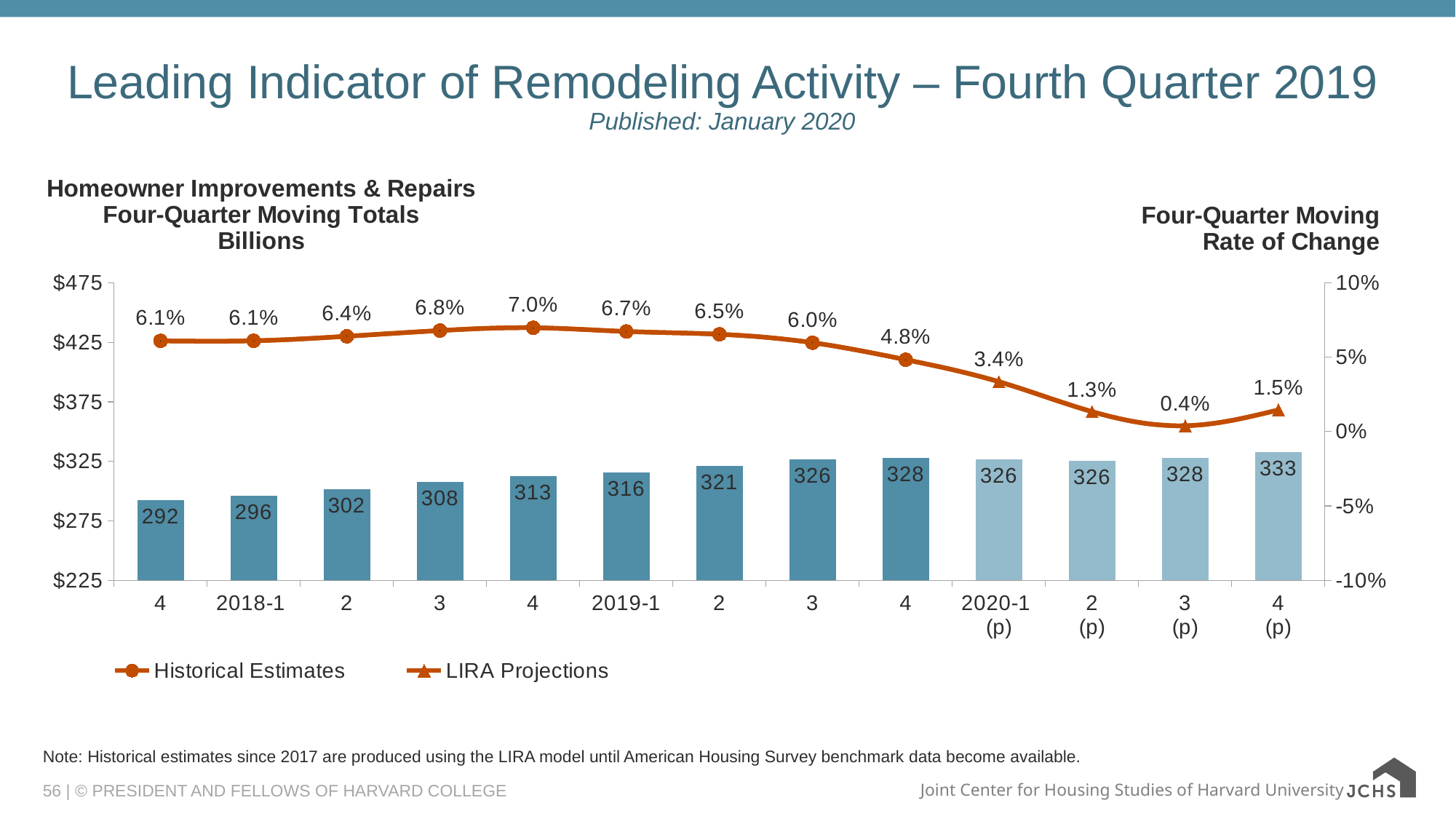
What is the four-quarter moving total (in billions) for 2019-1? 316 What is the four-quarter moving total (in billions) for 2020-4 (p)? 333 Which is larger, the rate of change for 2019-4 or the rate of change for 2020-1 (p)? 2019-4 Does the four-quarter moving rate of change rise or fall from 2018-4 to 2020-3 (p)? Fall What is the difference between the rate of change for 2018-4 and the rate of change for 2020-3 (p)? 6.6% Which quarter has the highest four-quarter moving rate of change? 2018-4 Which quarter has the lowest four-quarter moving total? 2017-4 How many series does the legend list? 2 How many quarters are plotted on the x axis? 13 What is the difference between the four-quarter moving totals for 2020-4 (p) and 2017-4? 41 What is the four-quarter moving rate of change shown for 2020-3 (p)? 0.4% What kind of chart is this? Combined bar and line chart